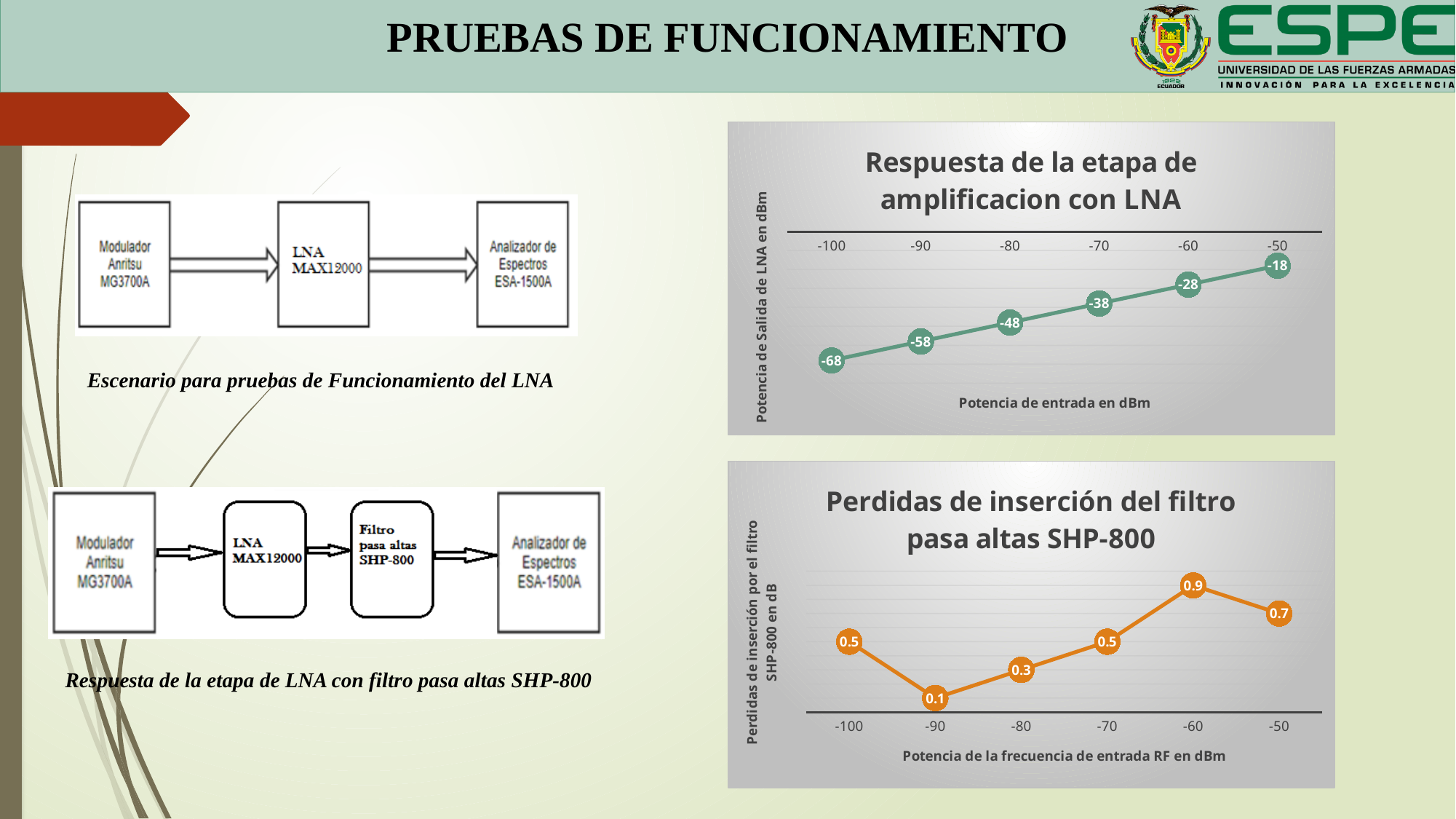
How many data points are plotted in the chart 'Respuesta de la etapa de amplificacion con LNA'? 6 What type of chart is 'Perdidas de inserción del filtro pasa altas SHP-800'? line chart What is the x-axis label of the chart 'Perdidas de inserción del filtro pasa altas SHP-800'? Potencia de la frecuencia de entrada RF en dBm In the chart 'Respuesta de la etapa de amplificacion con LNA', at which input power is the output power highest? -50 In the chart 'Respuesta de la etapa de amplificacion con LNA', what is the output power at an input power of -100 dBm? -68 In the chart 'Perdidas de inserción del filtro pasa altas SHP-800', what is the difference between the insertion loss at -60 dBm and at -90 dBm? 0.8 In the chart 'Respuesta de la etapa de amplificacion con LNA', what is the output power at an input power of -70 dBm? -38 In the chart 'Perdidas de inserción del filtro pasa altas SHP-800', what is the insertion loss at -60 dBm? 0.9 In the chart 'Respuesta de la etapa de amplificacion con LNA', what is the difference between the output power at -50 dBm and at -100 dBm? 50 In the chart 'Respuesta de la etapa de amplificacion con LNA', do the values rise or fall as the input power increases from -100 to -50 dBm? rise In the chart 'Perdidas de inserción del filtro pasa altas SHP-800', which is larger: the insertion loss at -60 dBm or at -50 dBm? -60 dBm In the chart 'Perdidas de inserción del filtro pasa altas SHP-800', at which input power is the insertion loss lowest? -90